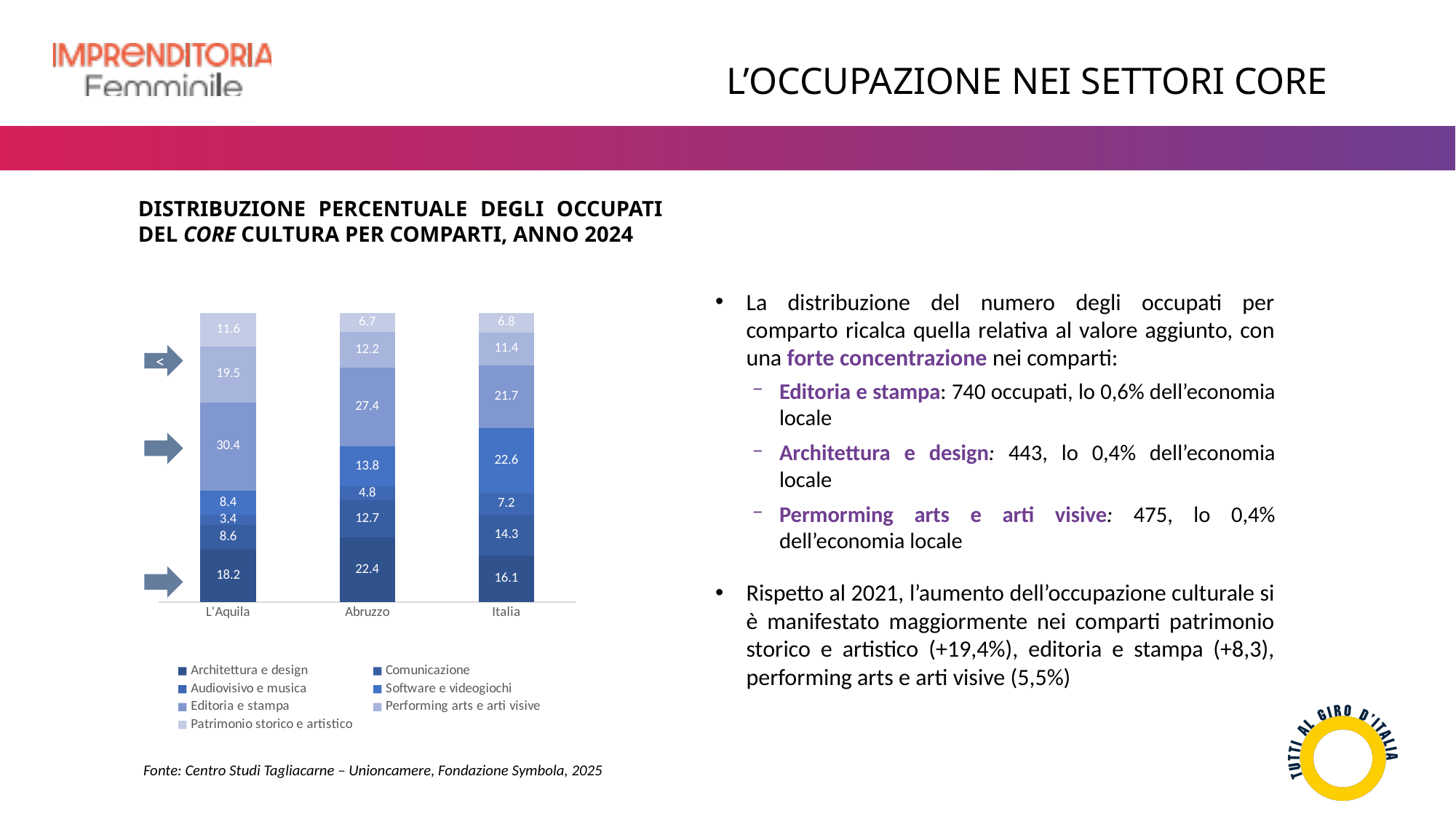
What kind of chart is shown on the slide? stacked bar chart Which territory has the highest value for the bottom segment (Architettura e design)? Abruzzo What is the value of the bottom segment (Architettura e design) for Abruzzo? 22.4 What is the value of the bottom segment (Architettura e design) for Italia? 16.1 Which is larger: the Software e videogiochi value for Italia or for Abruzzo? Italia What is the source cited below the chart? Centro Studi Tagliacarne – Unioncamere, Fondazione Symbola, 2025 What is the value of the Editoria e stampa segment for L'Aquila? 30.4 How many series does the chart legend list? 7 What is the value of the top segment (Patrimonio storico e artistico) for L'Aquila? 11.6 Which territory has the lowest value for the top segment (Patrimonio storico e artistico)? Abruzzo What is the difference between the Editoria e stampa values for L'Aquila and Italia? 8.7 How many categories (territories) are shown on the x axis of the chart? 3